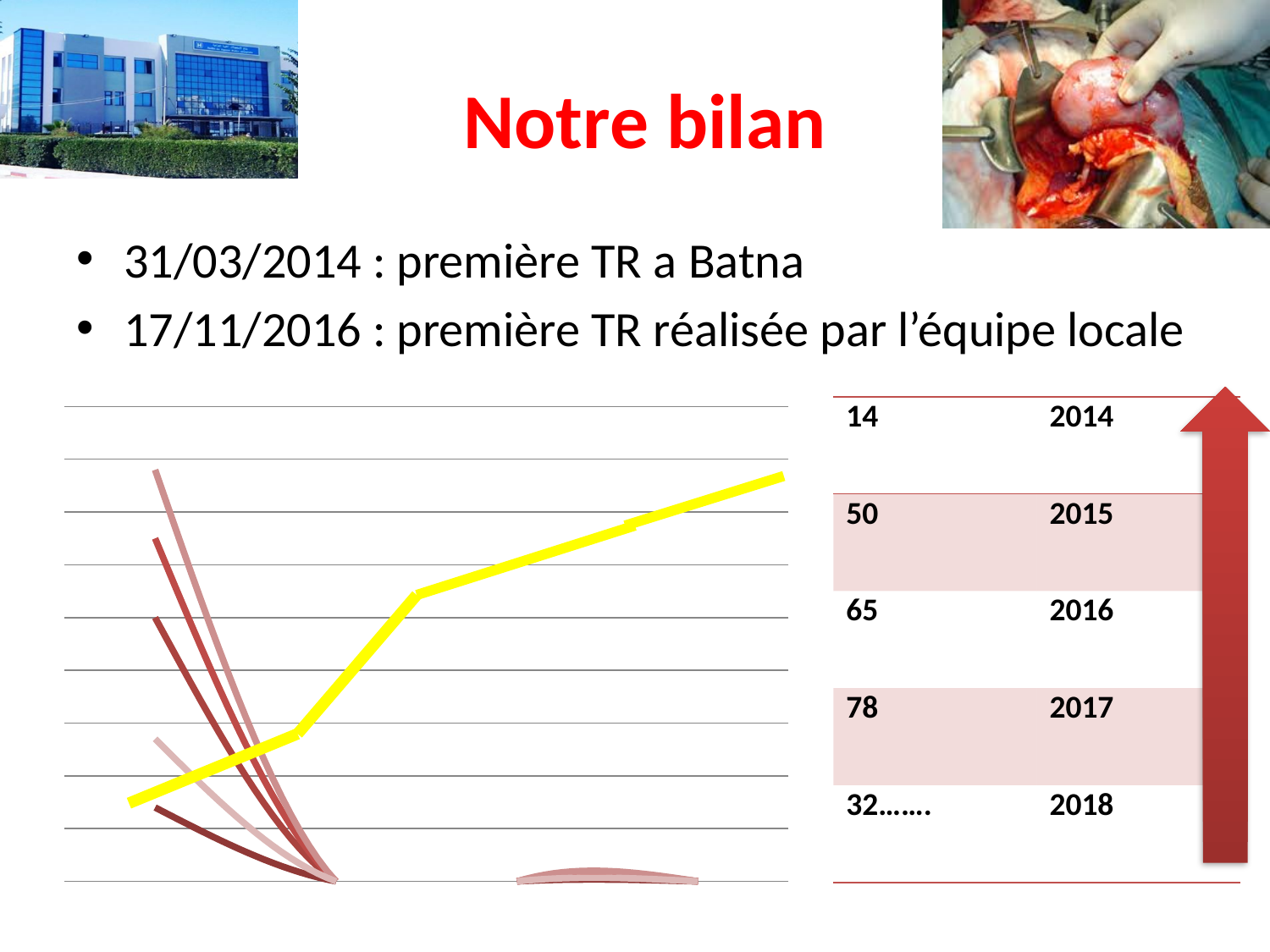
Does the yellow line in the chart rise or fall from left to right? rise What kind of chart is shown on the left of the slide? line chart What colour is the line in the chart that rises from left to right? yellow